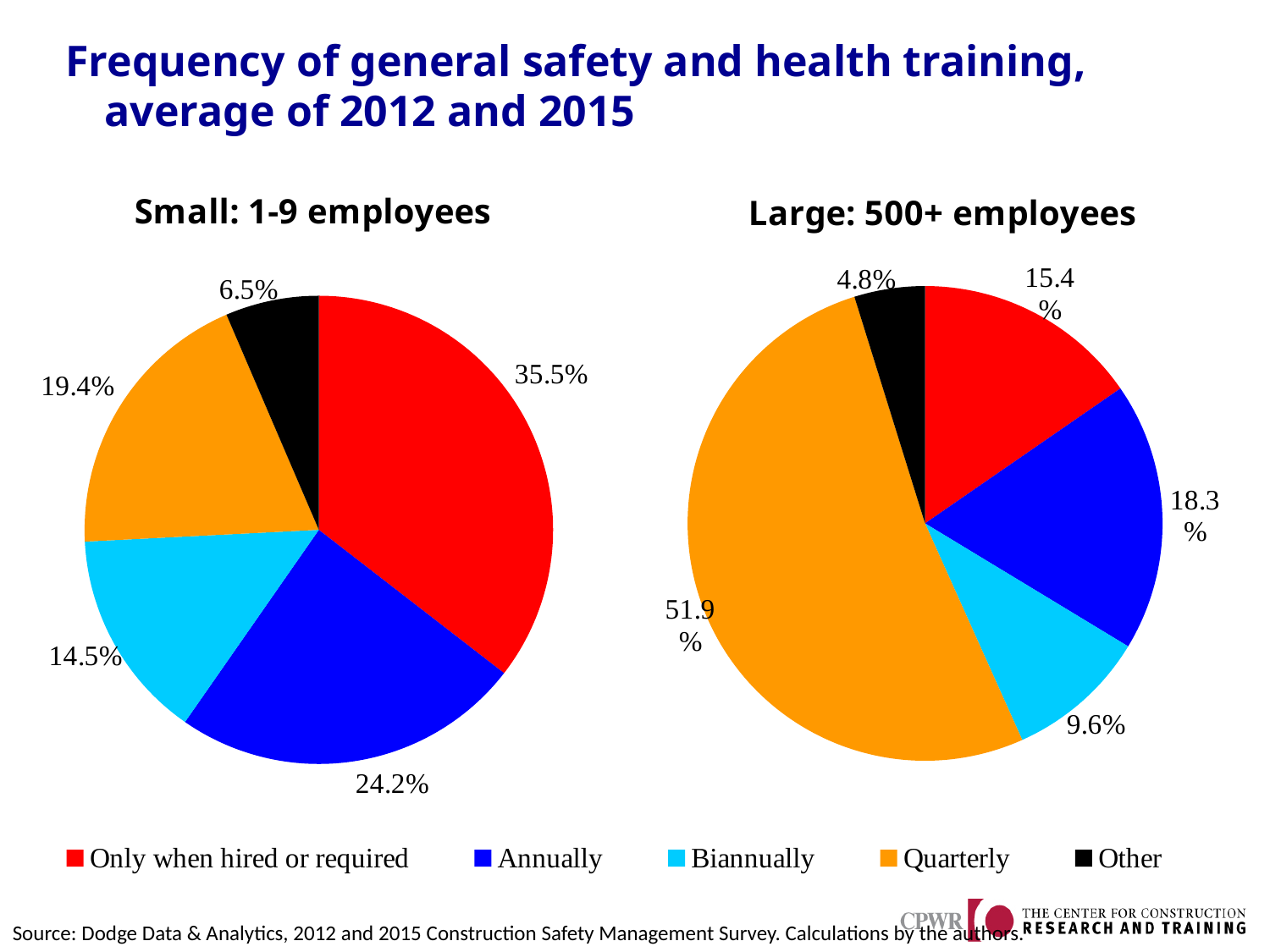
In the 'Small: 1-9 employees' chart, what is the difference between the 'Annually' and 'Biannually' shares? 9.7% In the 'Large: 500+ employees' chart, what share is 'Biannually'? 9.6% In the 'Small: 1-9 employees' chart, what share is 'Only when hired or required'? 35.5% What kind of charts are shown on the slide? Pie charts In the 'Small: 1-9 employees' chart, what share is 'Other'? 6.5% In the 'Large: 500+ employees' chart, what share is 'Quarterly'? 51.9% In the 'Large: 500+ employees' chart, which category has the smallest share? Other Which colour represents 'Quarterly' in the legend? Orange In the 'Small: 1-9 employees' chart, which category has the largest share? Only when hired or required In the 'Large: 500+ employees' chart, which is larger: 'Annually' or 'Only when hired or required'? Annually What is the difference between the 'Quarterly' shares in the 'Large: 500+ employees' chart and the 'Small: 1-9 employees' chart? 32.5% How many series does the legend list? 5